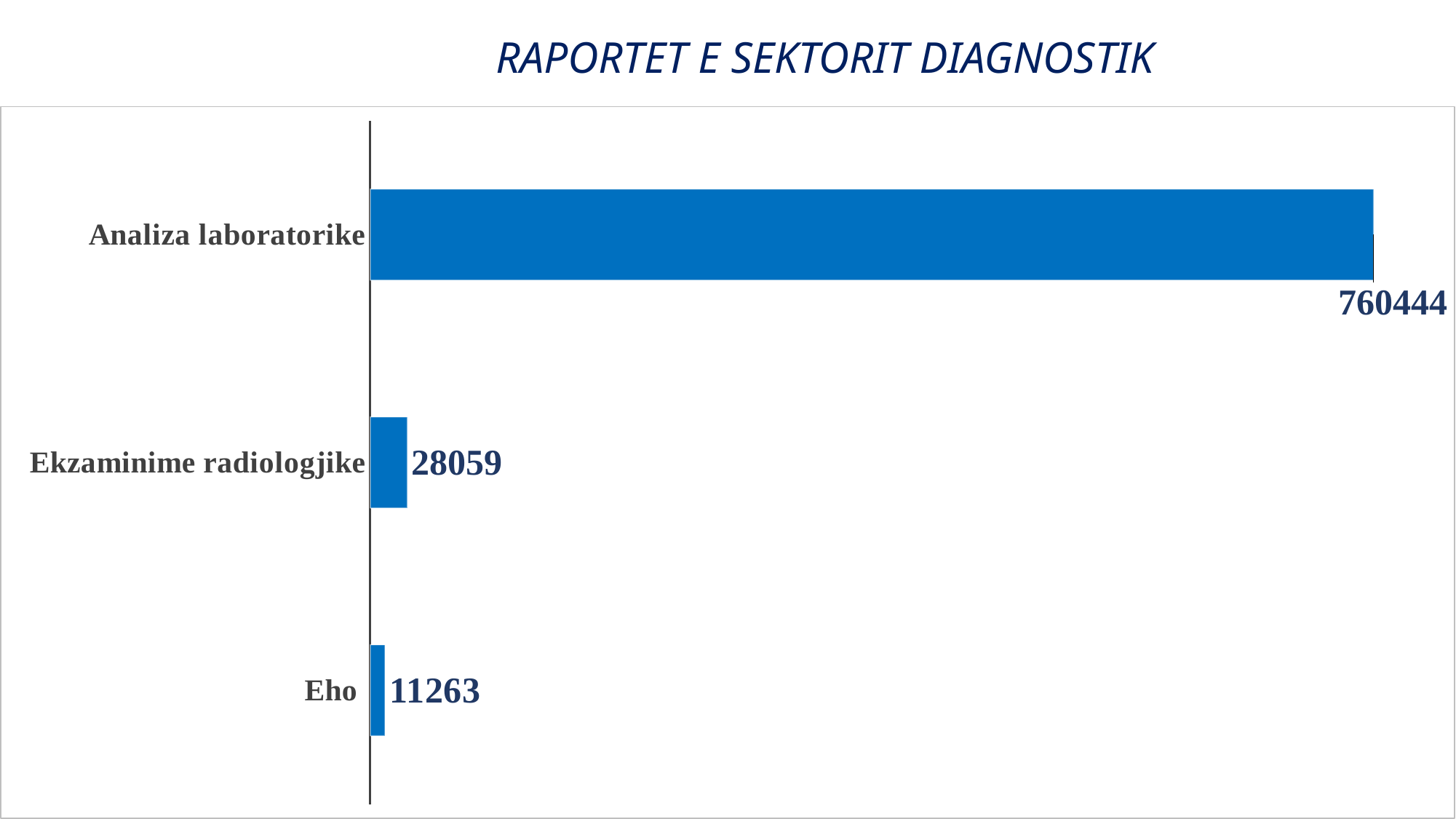
Which category has the highest value? Analiza laboratorike What kind of chart is shown on the slide? Bar chart How many categories are shown in the chart? 3 Which category has the lowest value? Eho What is the value for Eho? 11263 What is the title of the slide? RAPORTET E SEKTORIT DIAGNOSTIK What is the value for Ekzaminime radiologjike? 28059 What colour are the bars in the chart? Blue What is the difference between the values for Ekzaminime radiologjike and Eho? 16796 What is the value for Analiza laboratorike? 760444 Which is larger, the value for Ekzaminime radiologjike or the value for Eho? Ekzaminime radiologjike What is the difference between the values for Analiza laboratorike and Ekzaminime radiologjike? 732385